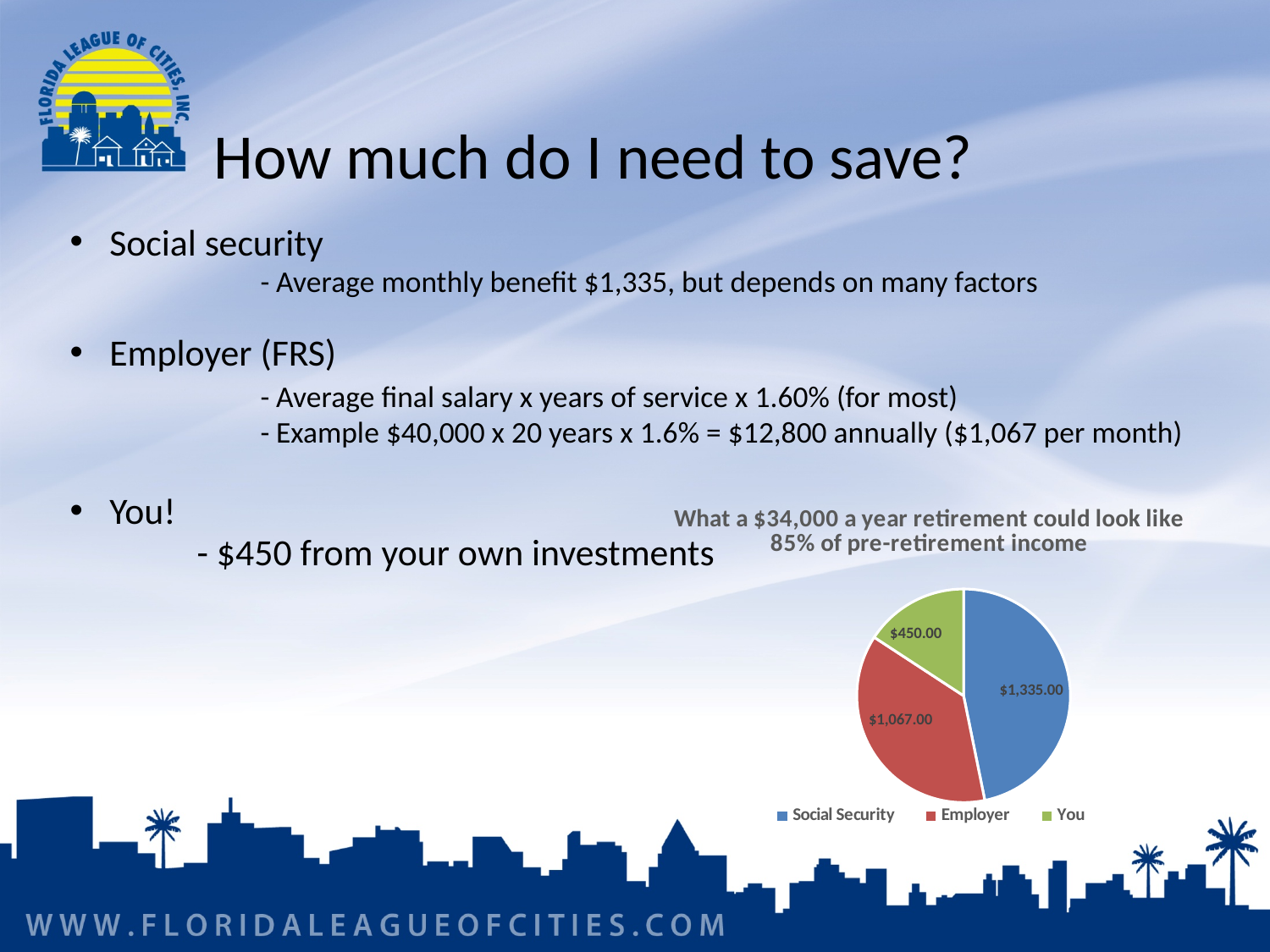
How many entries does the pie chart legend list? 3 Which slice of the pie chart has the smallest value? You Which slice of the pie chart has the largest value? Social Security What is the value of the Social Security slice in the pie chart? $1,335.00 What is the difference between the Social Security and Employer values in the pie chart? $268.00 What is the value of the You slice in the pie chart? $450.00 What is the difference between the Employer and You values in the pie chart? $617.00 Which is larger in the pie chart, the Employer slice or the You slice? Employer What is the value of the Employer slice in the pie chart? $1,067.00 What colour is the Employer slice in the pie chart? red What type of chart is shown on the slide? pie chart How many slices does the pie chart have? 3